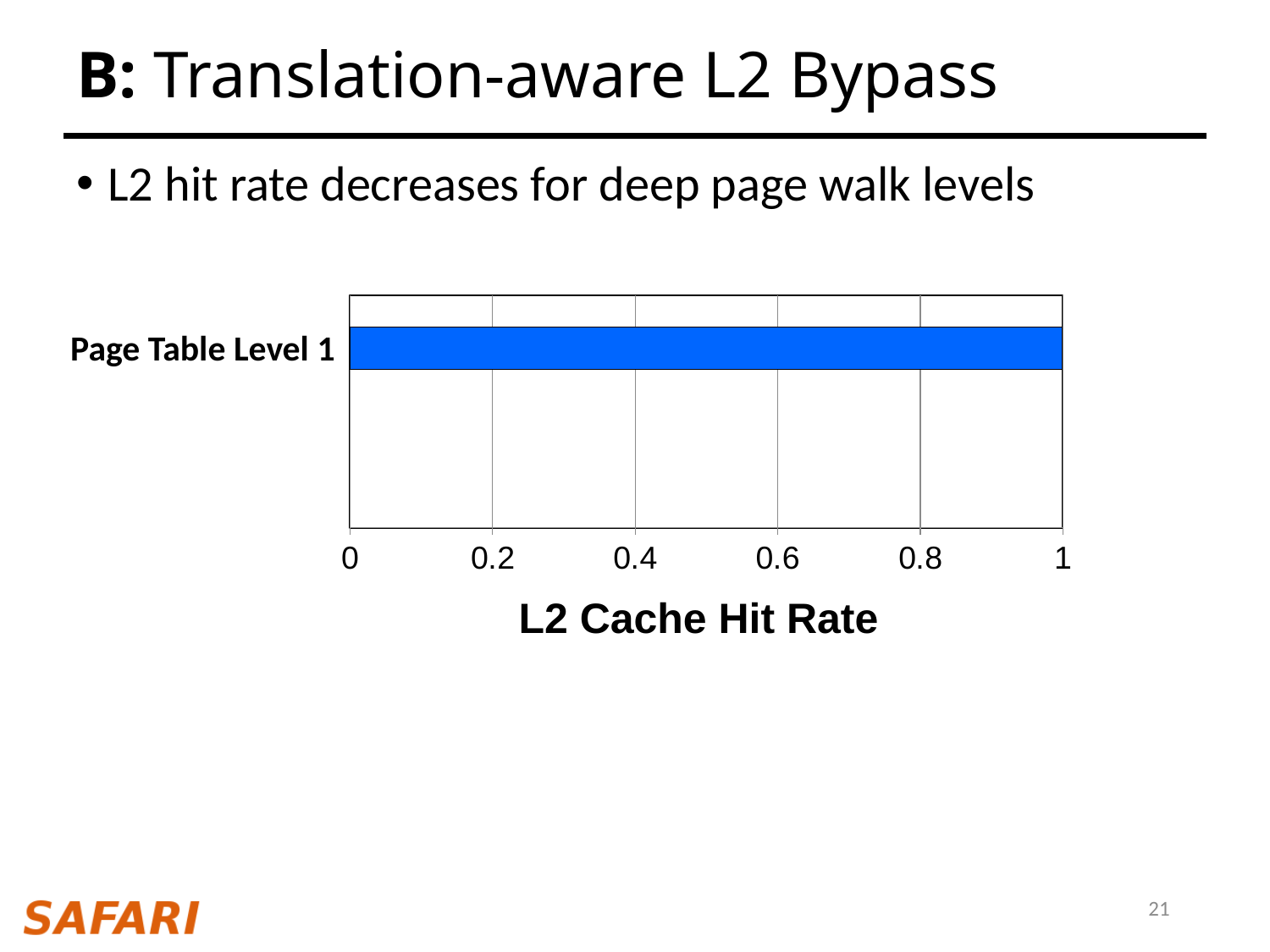
What is the label of the category plotted on the chart? Page Table Level 1 Is the value for Page Table Level 1 greater or less than 0.8? greater What is the highest tick value shown on the horizontal axis? 1 Is the value for Page Table Level 1 greater or less than 0.6? greater What is the title of the horizontal axis of the chart? L2 Cache Hit Rate What kind of chart is shown on the slide? bar chart How many labeled categories are shown on the chart? 1